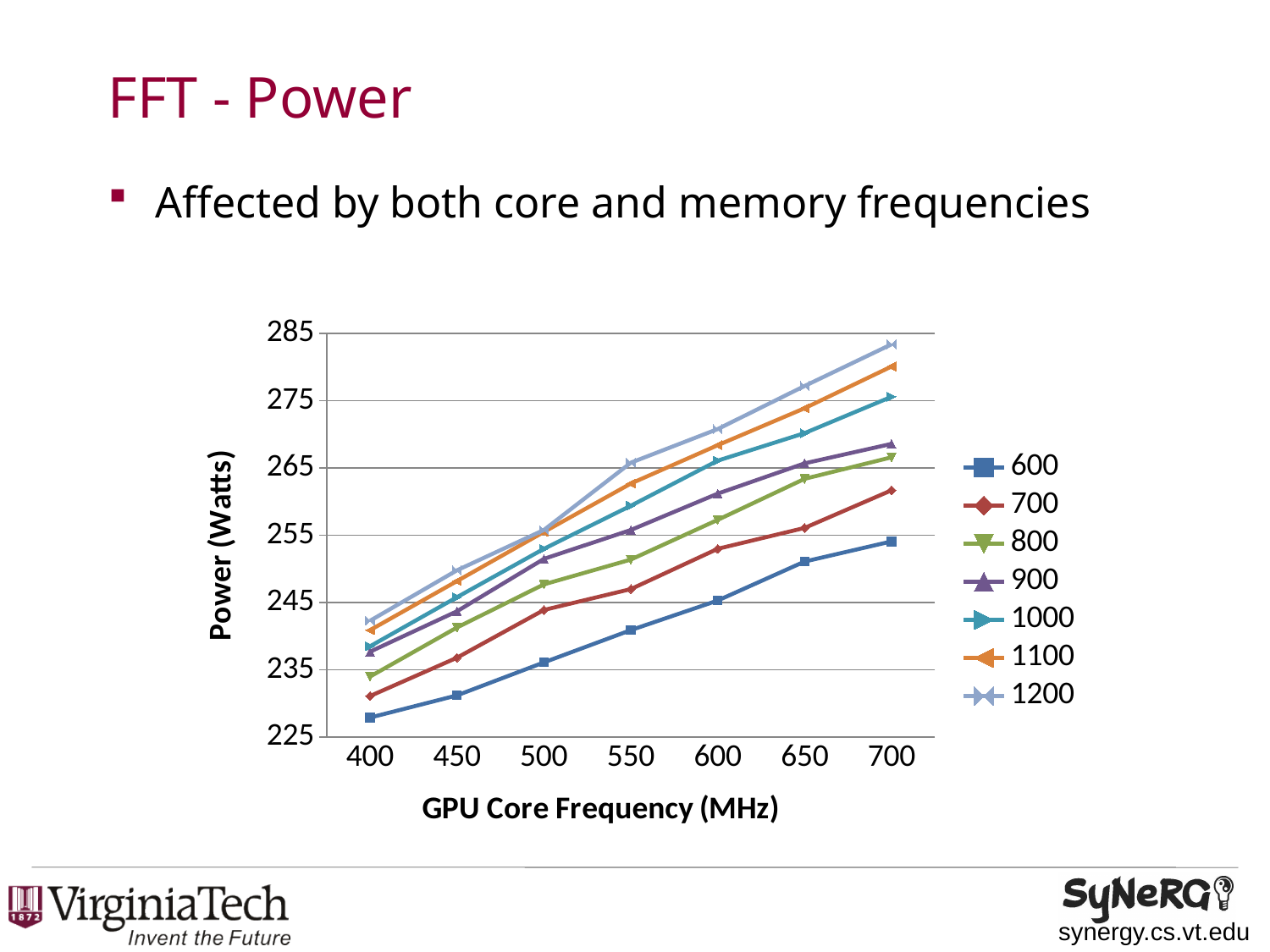
Is the power for the 600 series at 400 MHz greater or less than 235? less Is the power for the 700 series at 700 MHz greater or less than 255? greater Which series has the lowest power at 400 MHz? 600 Is the power for the 1200 series at 700 MHz greater or less than 275? greater How many GPU core frequency values are plotted along the x axis? 7 At 700 MHz, which series has the larger power, 600 or 1200? 1200 What is the title of the y axis? Power (Watts) Does the power for the 600 series rise or fall as GPU core frequency increases from 400 to 700 MHz? rise What kind of chart is shown on the slide? line chart How many series does the legend list? 7 Which series has the highest power at 700 MHz? 1200